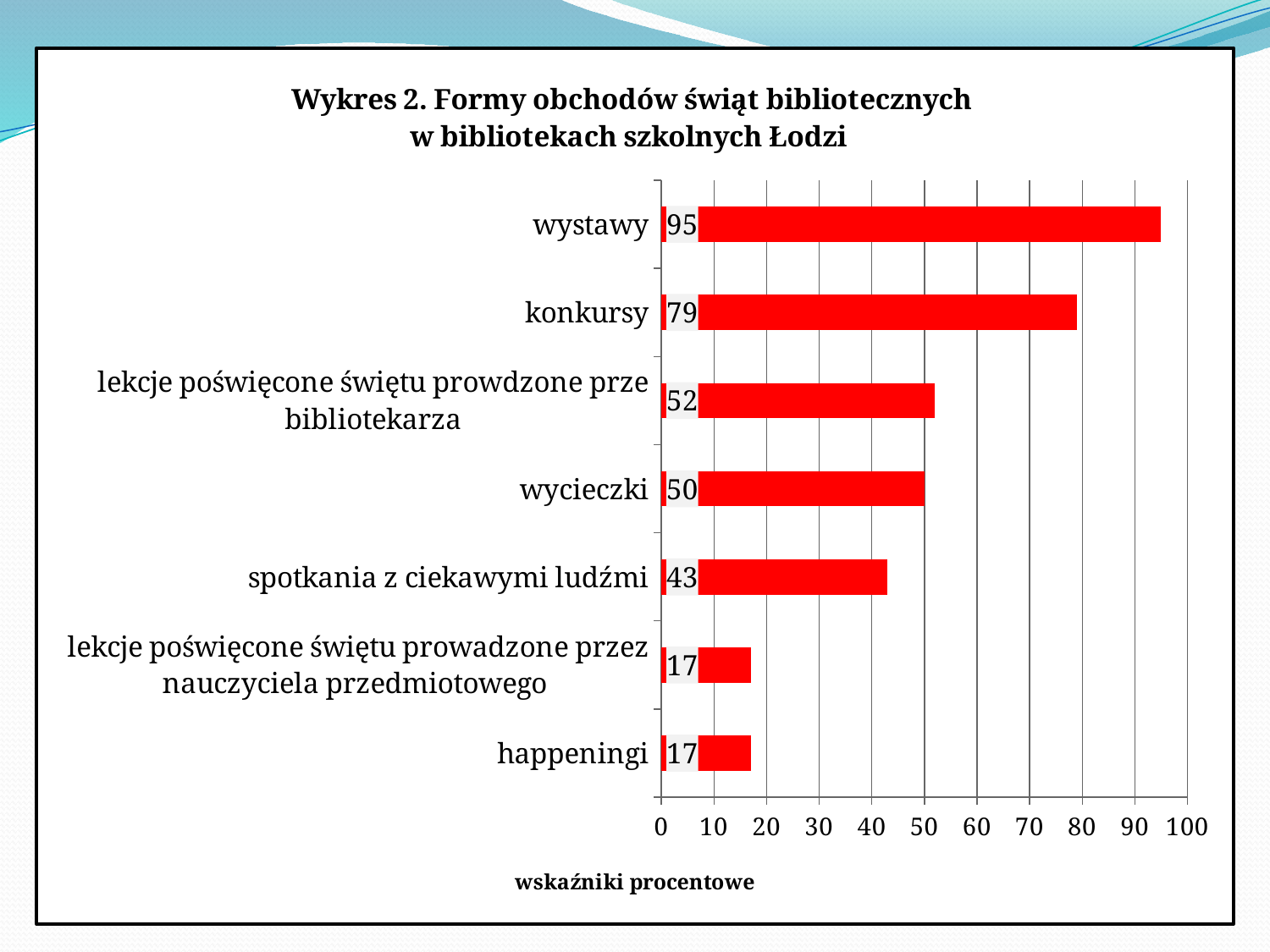
What is the difference between the values for wycieczki and happeningi? 33 What is the value for happeningi? 17 Which is larger: the value for lekcje poświęcone świętu prowdzone prze bibliotekarza or the value for wycieczki? lekcje poświęcone świętu prowdzone prze bibliotekarza What is the difference between the values for wystawy and konkursy? 16 What kind of chart is shown on the slide? bar chart Which is larger: the value for konkursy or the value for spotkania z ciekawymi ludźmi? konkursy What is the label of the horizontal axis? wskaźniki procentowe What is the value for spotkania z ciekawymi ludźmi? 43 How many categories are shown in the chart? 7 Which category has the highest value? wystawy What is the value for konkursy? 79 What is the value for wystawy? 95